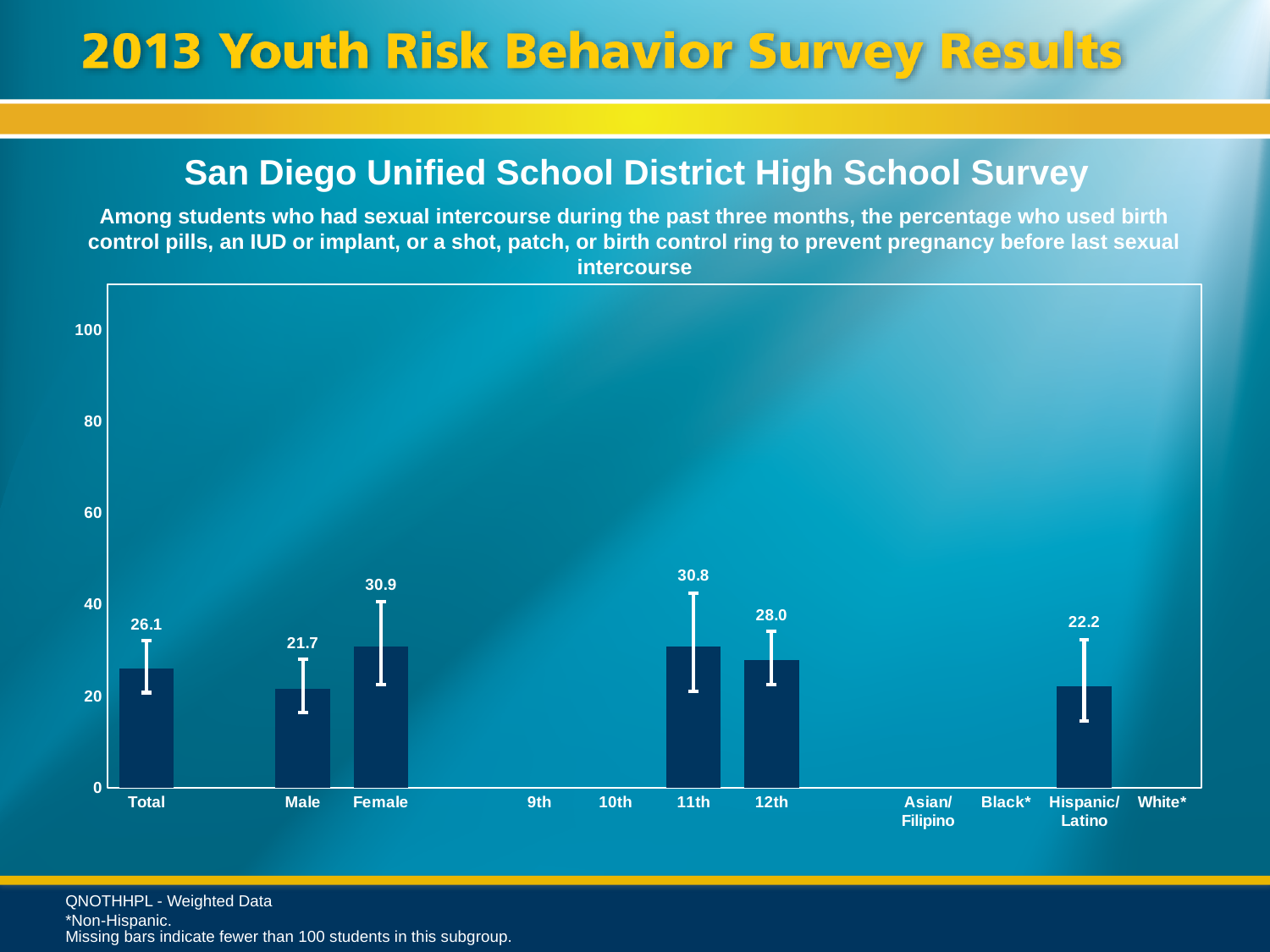
What is the value for Female? 30.9 What is the value for Hispanic/Latino? 22.2 Which category has the highest value among the plotted bars? Female What is the difference between the Female and Male values? 9.2 What is the value for 12th grade? 28.0 Which category has the lowest value among the plotted bars? Male What kind of chart is shown? bar chart Is the value for Male greater or less than 40? less What is the value for Total? 26.1 Which is larger, the value for 11th grade or the value for 12th grade? 11th How many bars are plotted on the chart? 6 Which categories on the x axis have no bar plotted? 9th, 10th, Asian/Filipino, Black*, White*